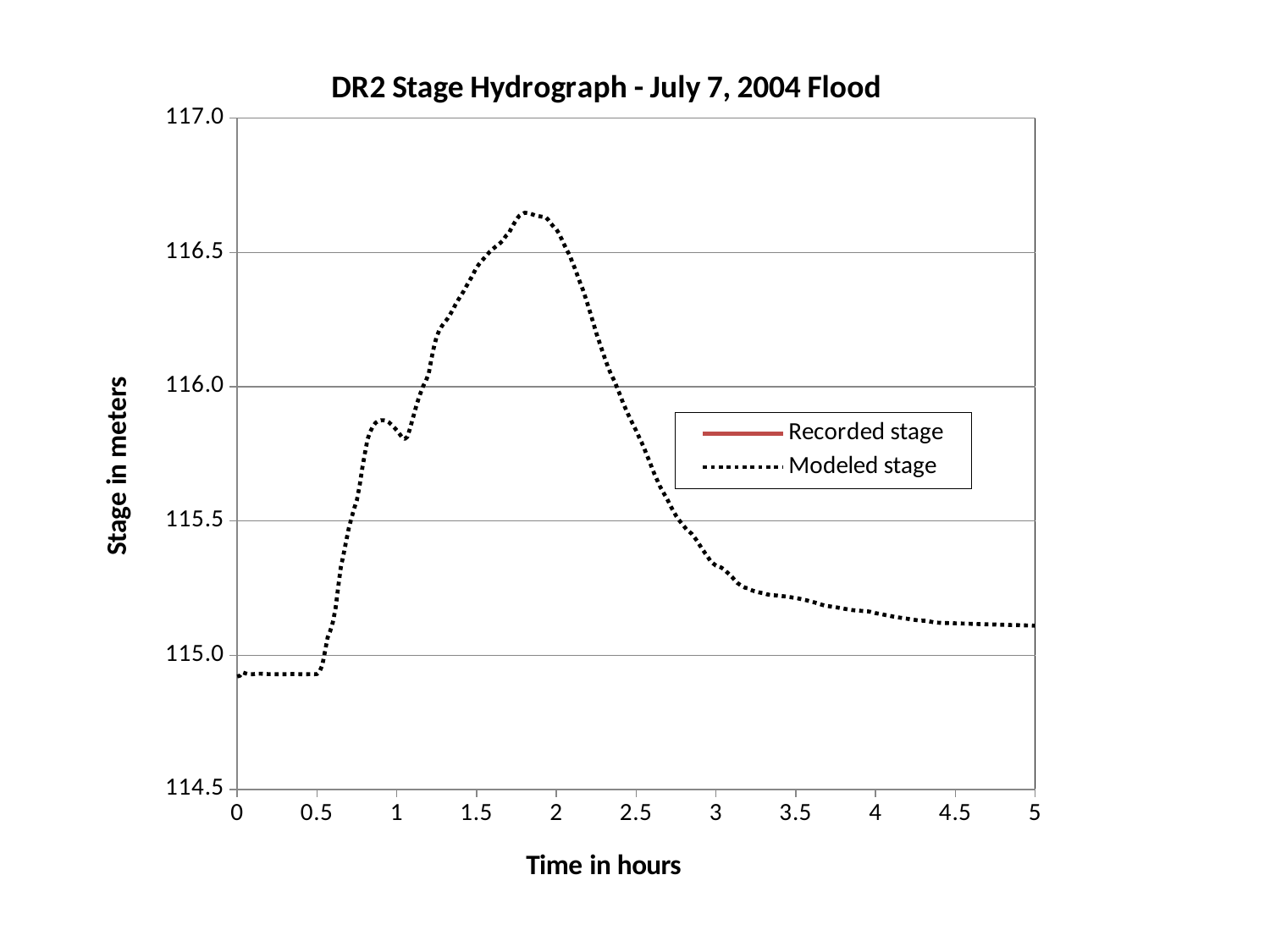
Which series is drawn as a dotted line? Modeled stage Is the modeled stage at 0 hours greater or less than 115.0? less Is the modeled stage at 3 hours greater or less than 115.5? less Is the modeled stage at 5 hours greater or less than 115.5? less What is the title of the chart? DR2 Stage Hydrograph - July 7, 2004 Flood Does the modeled stage rise or fall between 2 hours and 5 hours? fall Does the modeled stage reach its peak before or after 2 hours? before What kind of chart is shown on the slide? line chart How many series does the legend list? 2 Which is larger, the modeled stage at 1 hour or at 2 hours? 2 hours